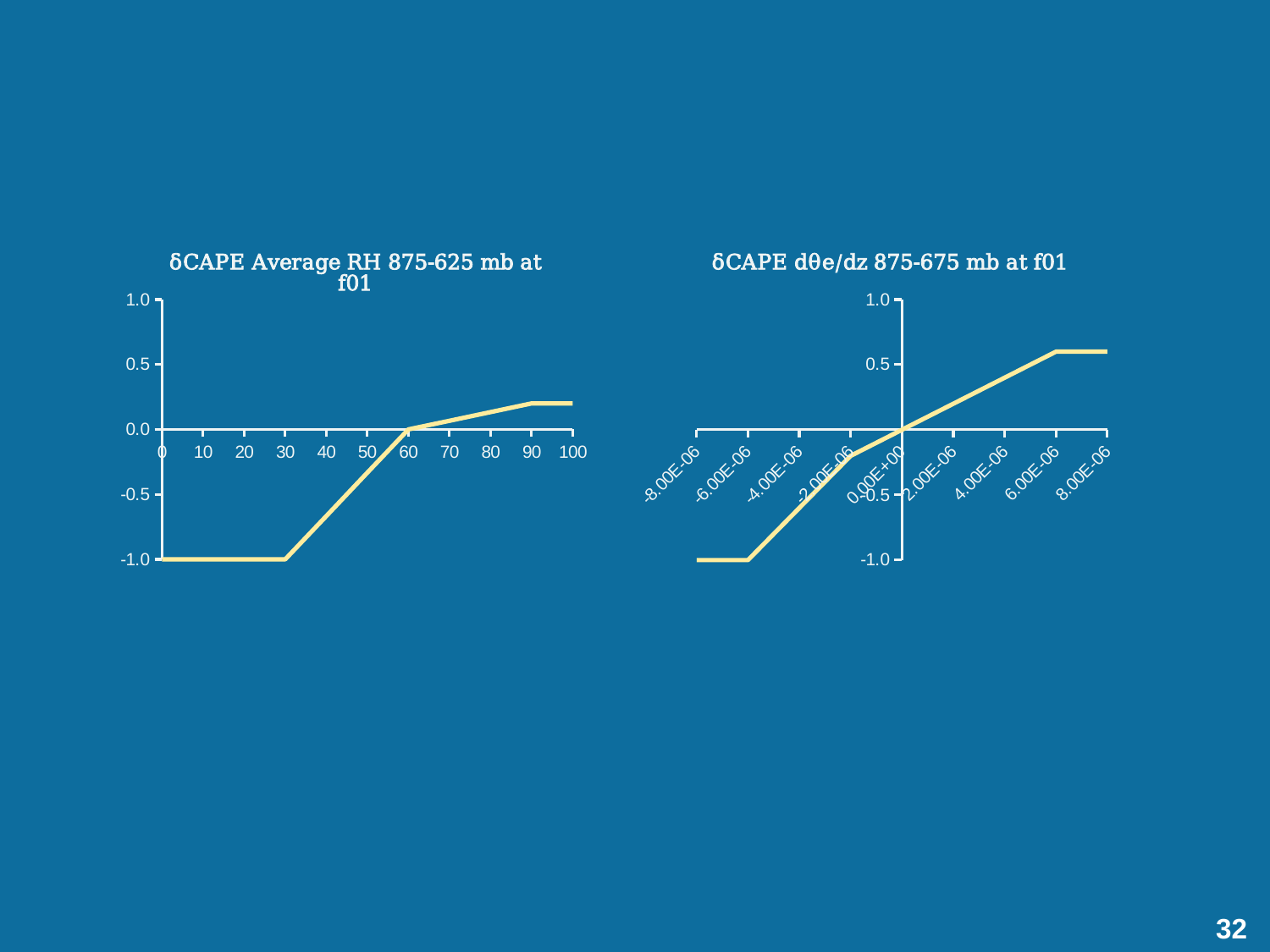
What kind of chart is the left chart titled "δCAPE Average RH 875-625 mb at f01"? line chart In the left chart "δCAPE Average RH 875-625 mb at f01", is the value at x = 40 greater or less than -0.5? less In the left chart "δCAPE Average RH 875-625 mb at f01", what is the value of the line at x = 30? -1.0 In the right chart "δCAPE dθe/dz 875-675 mb at f01", is the value at x = 8.00E-06 greater or less than 0.5? greater In the right chart "δCAPE dθe/dz 875-675 mb at f01", what is the value of the line at x = -8.00E-06? -1.0 In the right chart "δCAPE dθe/dz 875-675 mb at f01", does the line rise or fall as x increases from -6.00E-06 to 6.00E-06? rise In the left chart "δCAPE Average RH 875-625 mb at f01", what is the value of the line at x = 0? -1.0 In the right chart "δCAPE dθe/dz 875-675 mb at f01", what is the value of the line at x = 0.00E+00? 0.0 In the left chart "δCAPE Average RH 875-625 mb at f01", is the value at x = 100 greater or less than 0.5? less What kind of chart is the right chart titled "δCAPE dθe/dz 875-675 mb at f01"? line chart In the left chart "δCAPE Average RH 875-625 mb at f01", what is the value of the line at x = 60? 0.0 In the left chart "δCAPE Average RH 875-625 mb at f01", does the line rise or fall as x increases from 30 to 90? rise